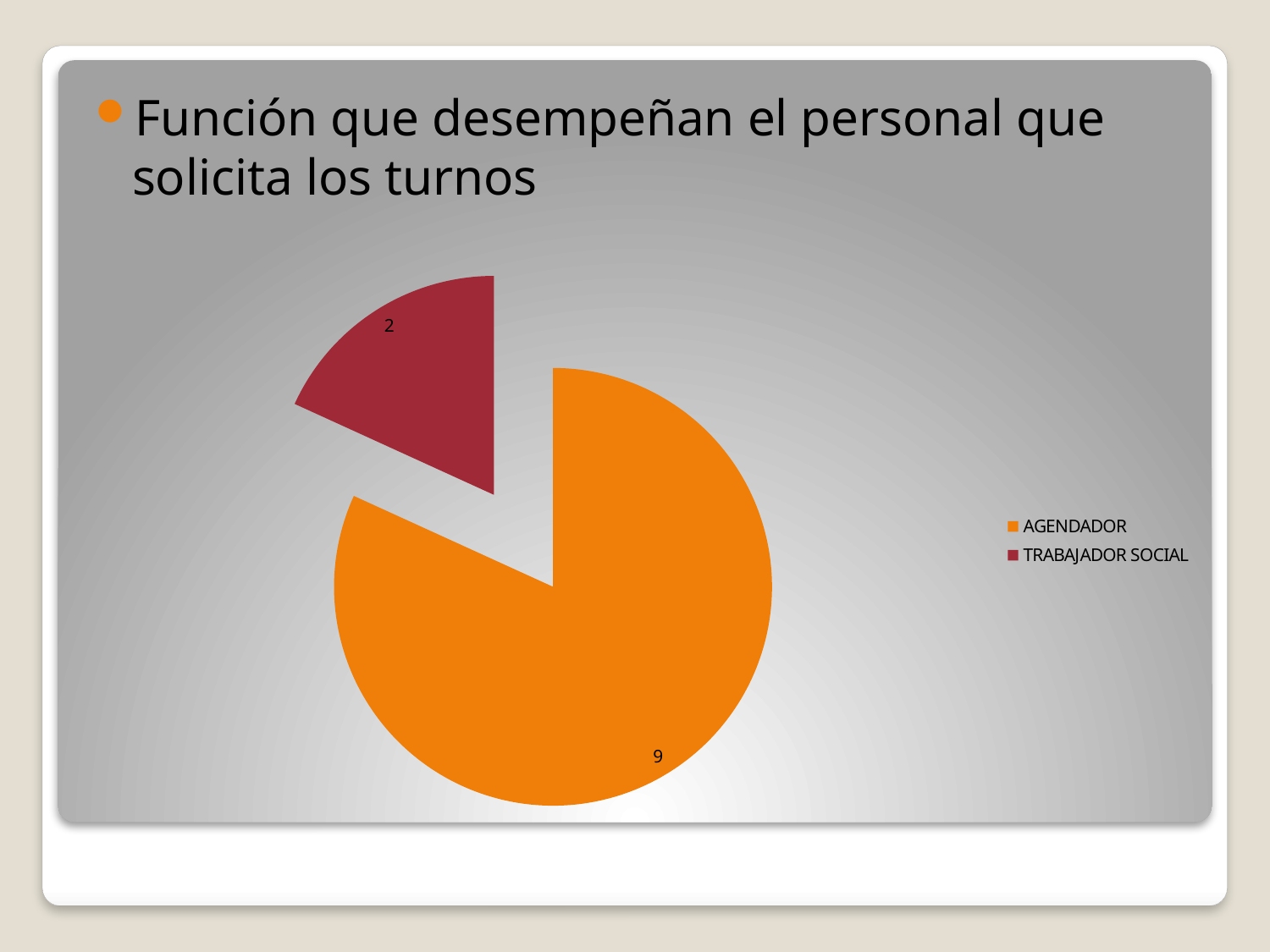
What is the difference between the values for AGENDADOR and TRABAJADOR SOCIAL? 7 What colour is the slice for TRABAJADOR SOCIAL? Dark red What is the total of all slices in the pie chart? 11 What is the value for TRABAJADOR SOCIAL? 2 What colour is the slice for AGENDADOR? Orange Which category has the largest slice of the pie? AGENDADOR Which is larger, the value for AGENDADOR or the value for TRABAJADOR SOCIAL? AGENDADOR What is the value for AGENDADOR? 9 How many categories does the pie chart show? 2 What kind of chart is shown on the slide? Pie chart Which category has the smallest slice of the pie? TRABAJADOR SOCIAL